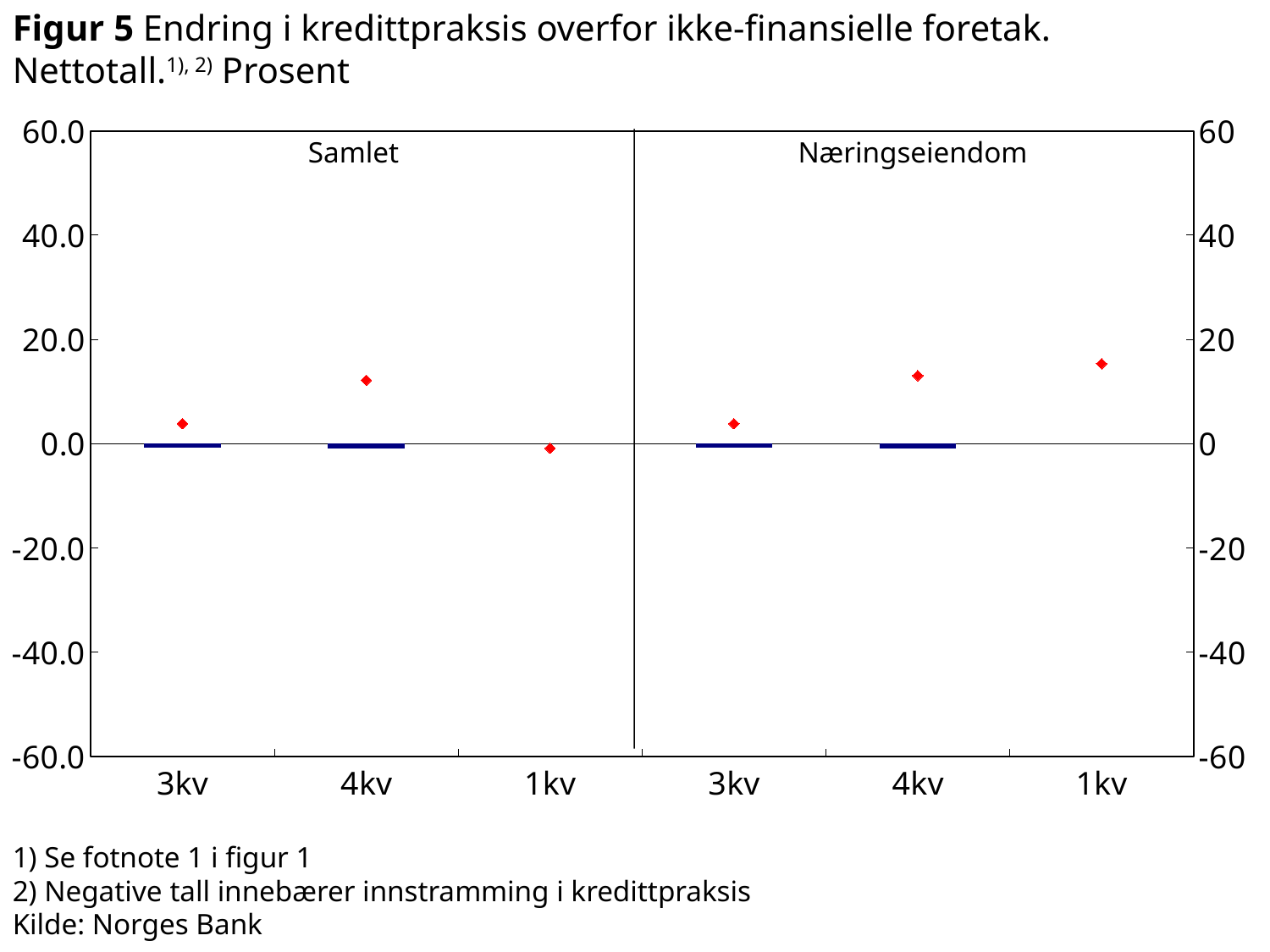
In the Næringseiendom panel, do the red diamonds rise or fall from 3kv to 1kv? rise In the Samlet panel, is the red diamond for 4kv greater or less than 0? greater Across both panels, which category has the lowest red diamond? 1kv in Samlet In the Næringseiendom panel, is the red diamond for 3kv greater or less than 0? greater In the Næringseiendom panel, which red diamond is higher, 3kv or 4kv? 4kv In the Næringseiendom panel, is the red diamond for 1kv greater or less than 20? less In the Samlet panel, which red diamond is higher, 3kv or 4kv? 4kv What is the title of the chart? Figur 5 Endring i kredittpraksis overfor ikke-finansielle foretak. Nettotall. Prosent What are the names of the two panels in the chart? Samlet and Næringseiendom How many categories are labelled on the x axis in total? 6